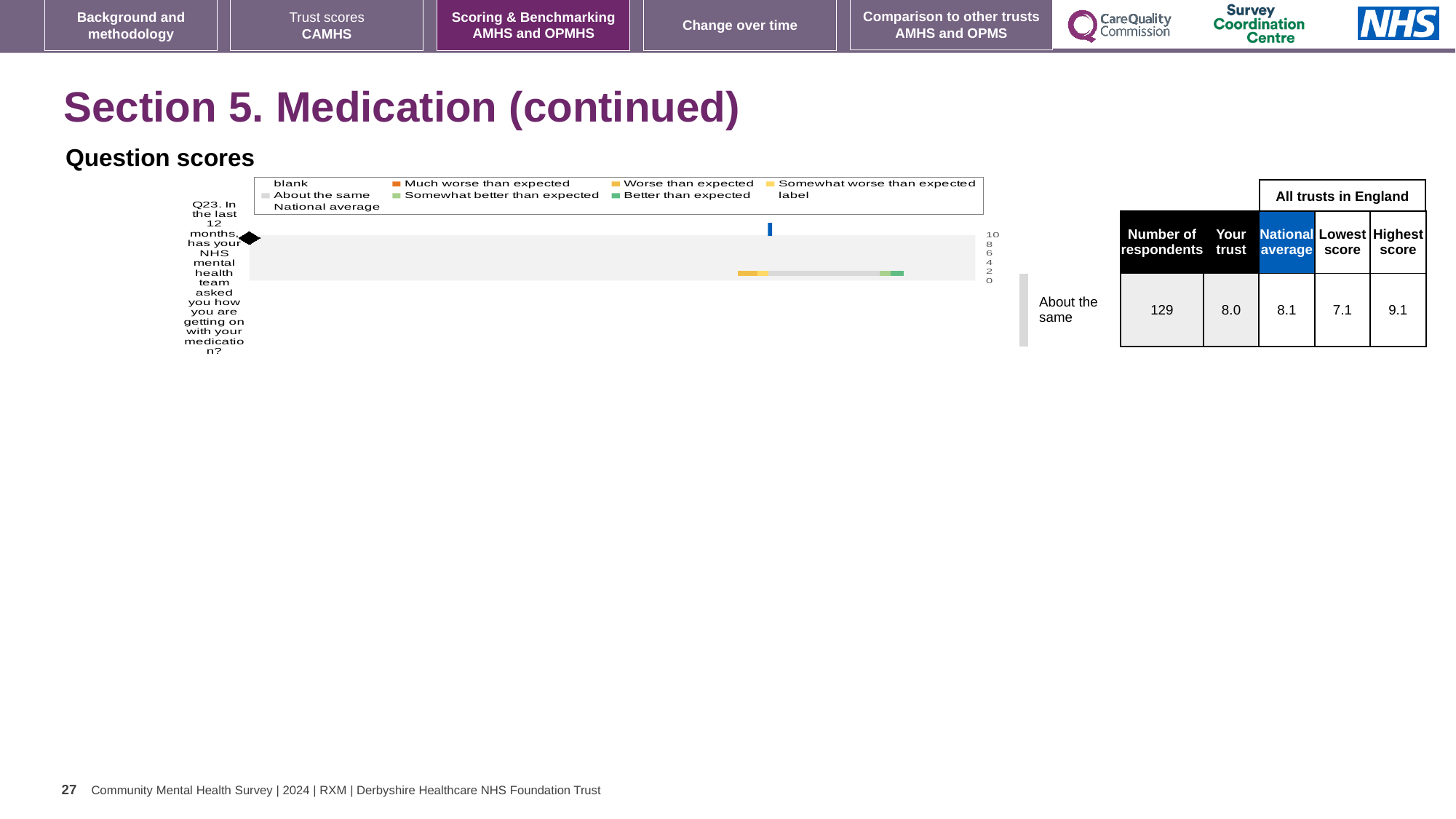
In the table next to the chart, which is larger for Q23: the 'Your trust' score or the national average? National average In the table next to the chart, what is the national average for Q23? 8.1 What is the highest value shown on the chart's axis? 10 According to the label beside the chart, how does the trust's score for Q23 compare with what is expected? About the same What kind of chart is shown under 'Question scores'? bar chart How many legend entries in the chart contain the word 'expected'? 5 How many survey questions are plotted in the chart? 1 Which question number is plotted in the chart? Q23 In the table next to the chart, what is the 'Your trust' score for Q23? 8.0 In the table next to the chart, what is the number of respondents for Q23? 129 In the table next to the chart, what is the difference between the highest score and the lowest score for Q23? 2.0